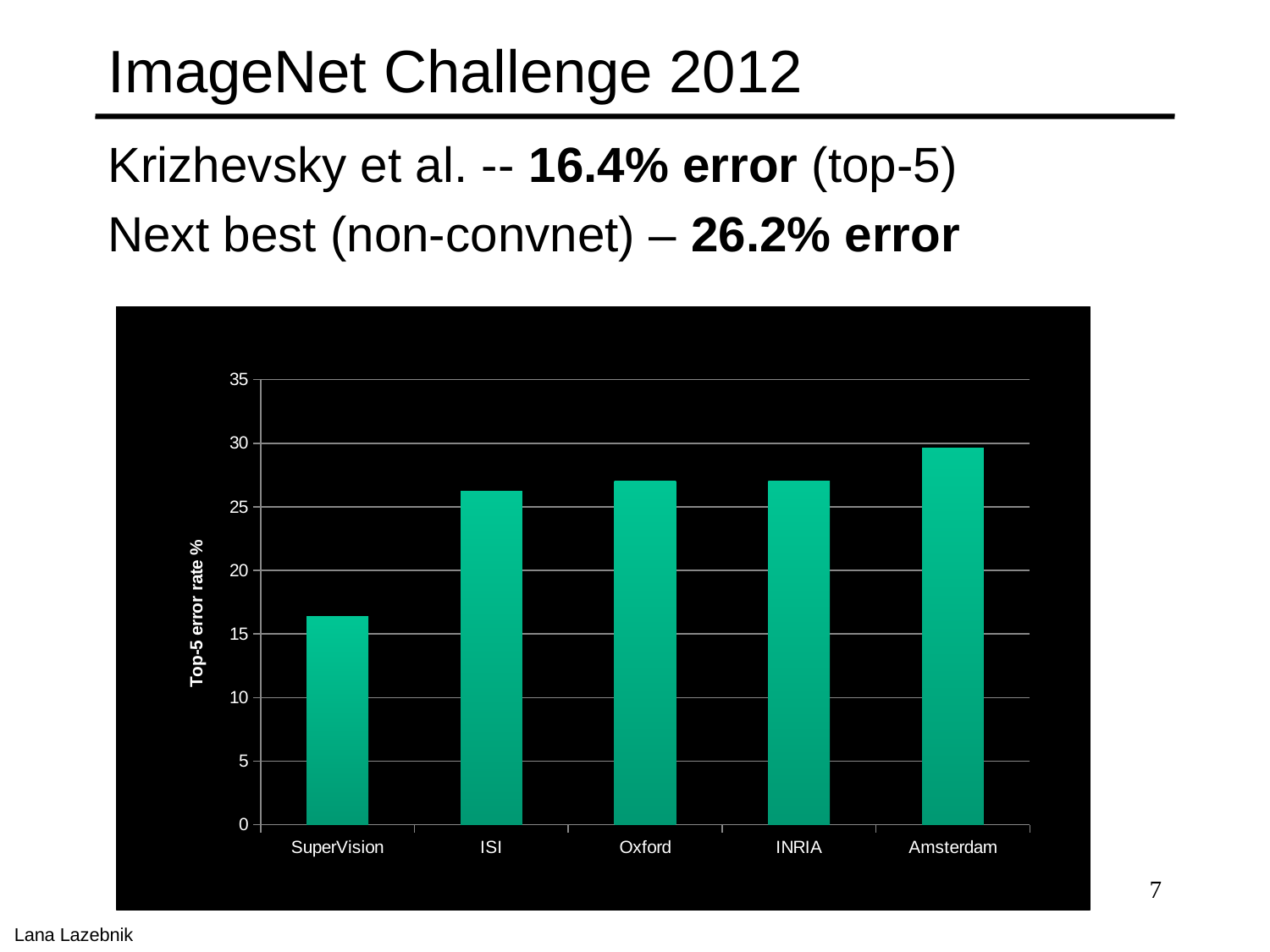
Is the value for Oxford greater or less than 25? greater Is the value for ISI greater or less than 25? greater Which has a larger top-5 error rate, SuperVision or ISI? ISI Which category has the lowest top-5 error rate in the chart? SuperVision What is the label of the y axis of the chart? Top-5 error rate % Which category has the highest top-5 error rate in the chart? Amsterdam Is the value for Amsterdam greater or less than 30? less Which has a larger top-5 error rate, Amsterdam or Oxford? Amsterdam How many categories are shown on the x axis of the chart? 5 What kind of chart is shown on the slide? bar chart